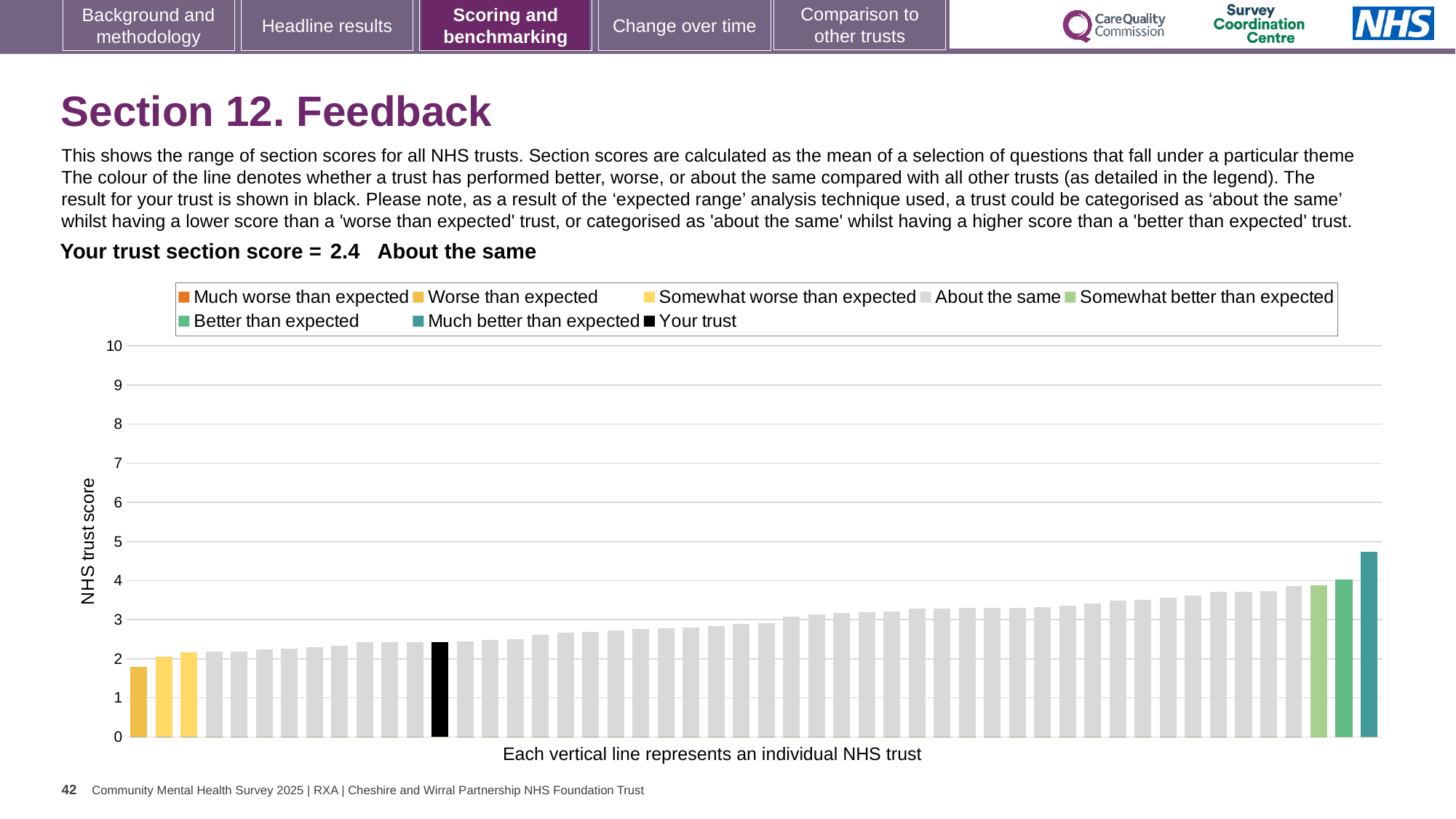
Which category is your trust placed in according to the slide? About the same Is the value of the shortest bar greater or less than 2? less What kind of chart is shown on the slide? bar chart Which legend category does the shortest bar belong to? Worse than expected What is the label on the vertical axis of the chart? NHS trust score Is the 'Your trust' bar taller or shorter than the 'Much better than expected' bar? shorter Do the bar values rise or fall from left to right along the x axis? rise Is the value of the tallest bar greater or less than 4? greater What is the section score for your trust shown on the slide? 2.4 Is the value of the black 'Your trust' bar greater or less than 3? less Which legend category does the tallest bar belong to? Much better than expected How many entries does the chart legend list? 8